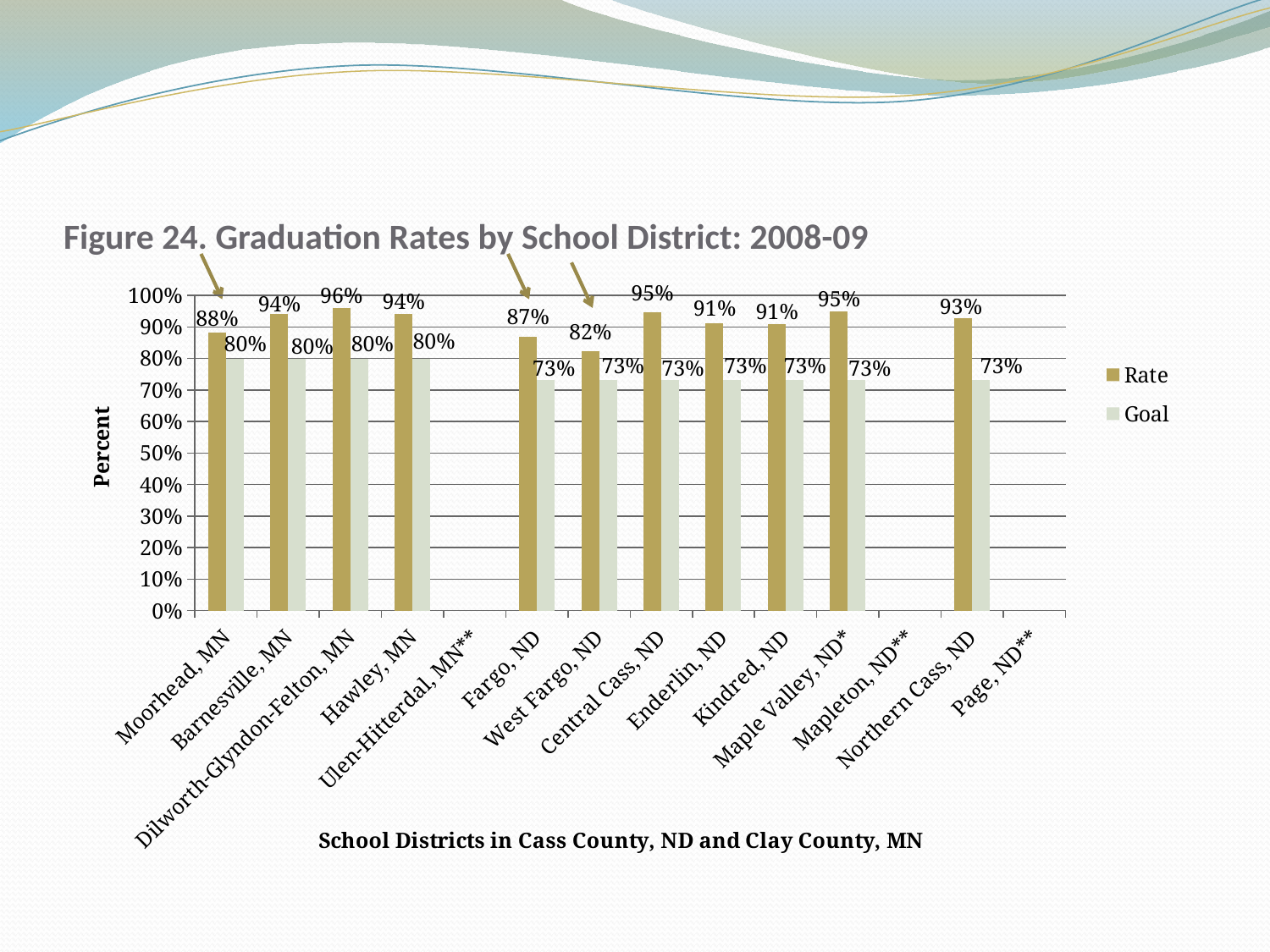
Which school district has the highest graduation Rate? Dilworth-Glyndon-Felton, MN What is the label of the y axis? Percent How many school districts are listed on the x axis? 14 What is the graduation Rate for Northern Cass, ND? 93% What is the difference between the Rate and the Goal for West Fargo, ND? 9% Among the districts with a plotted Rate, which has the lowest graduation Rate? West Fargo, ND How many series does the legend list? 2 Is the Rate for Central Cass, ND greater or less than 90%? greater What is the graduation Rate for Moorhead, MN? 88% What kind of chart is shown on the slide? Bar chart What is the Goal value for Fargo, ND? 73% Which is larger, the Rate for Barnesville, MN or the Rate for Fargo, ND? Barnesville, MN